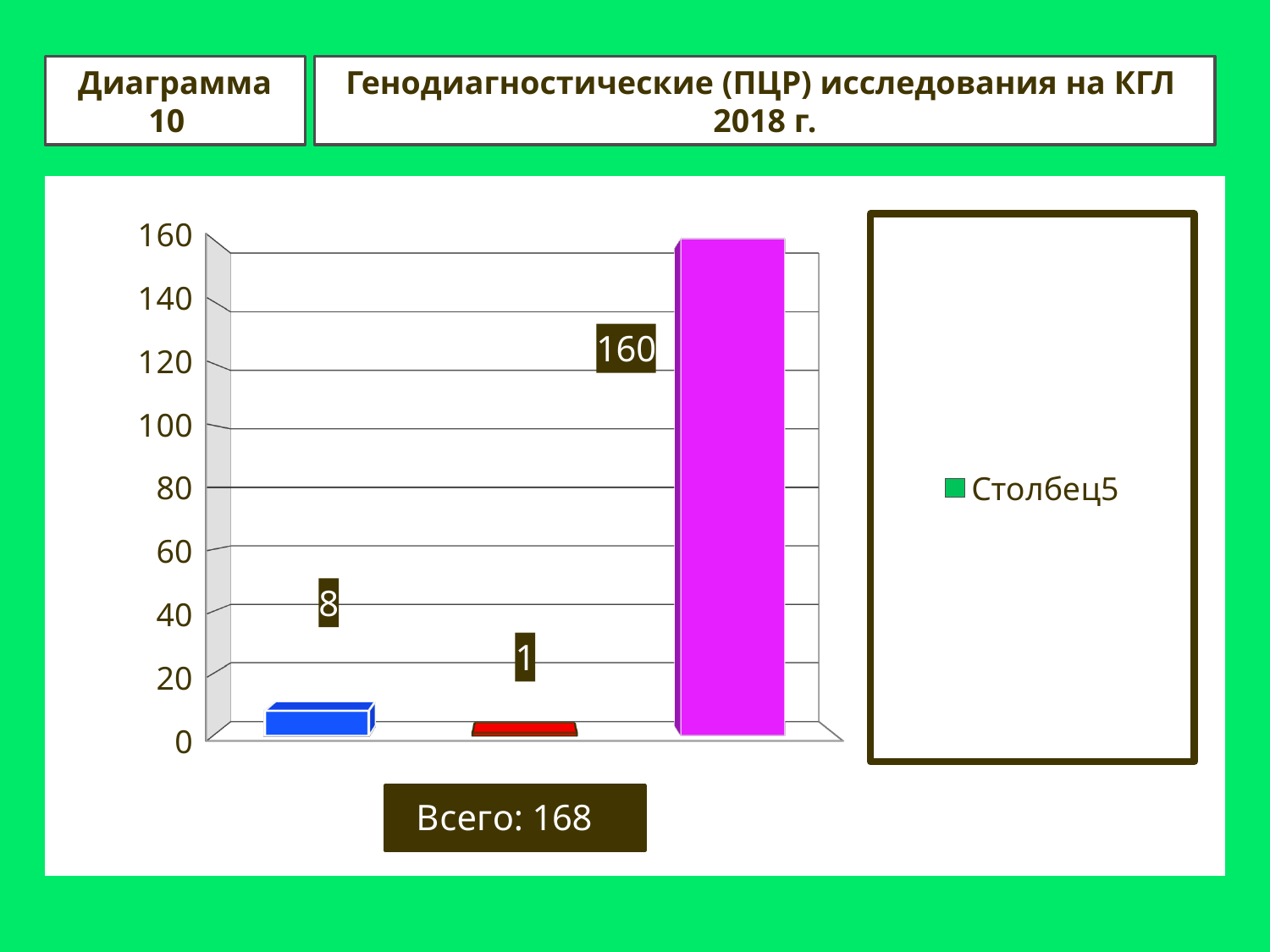
What total is printed below the chart? Всего: 168 What is the difference between the blue bar's value and the red bar's value? 7 What entry does the legend list? Столбец5 Which bar has the lowest value? the red bar What value is printed above the red bar? 1 What value is printed above the blue bar? 8 Which bar has the highest value? the magenta bar What is the difference between the magenta bar's value and the blue bar's value? 152 What value is printed next to the magenta bar? 160 Which is larger, the value of the blue bar or the value of the red bar? the blue bar How many bars are plotted in the chart? 3 What type of chart is shown on the slide? bar chart